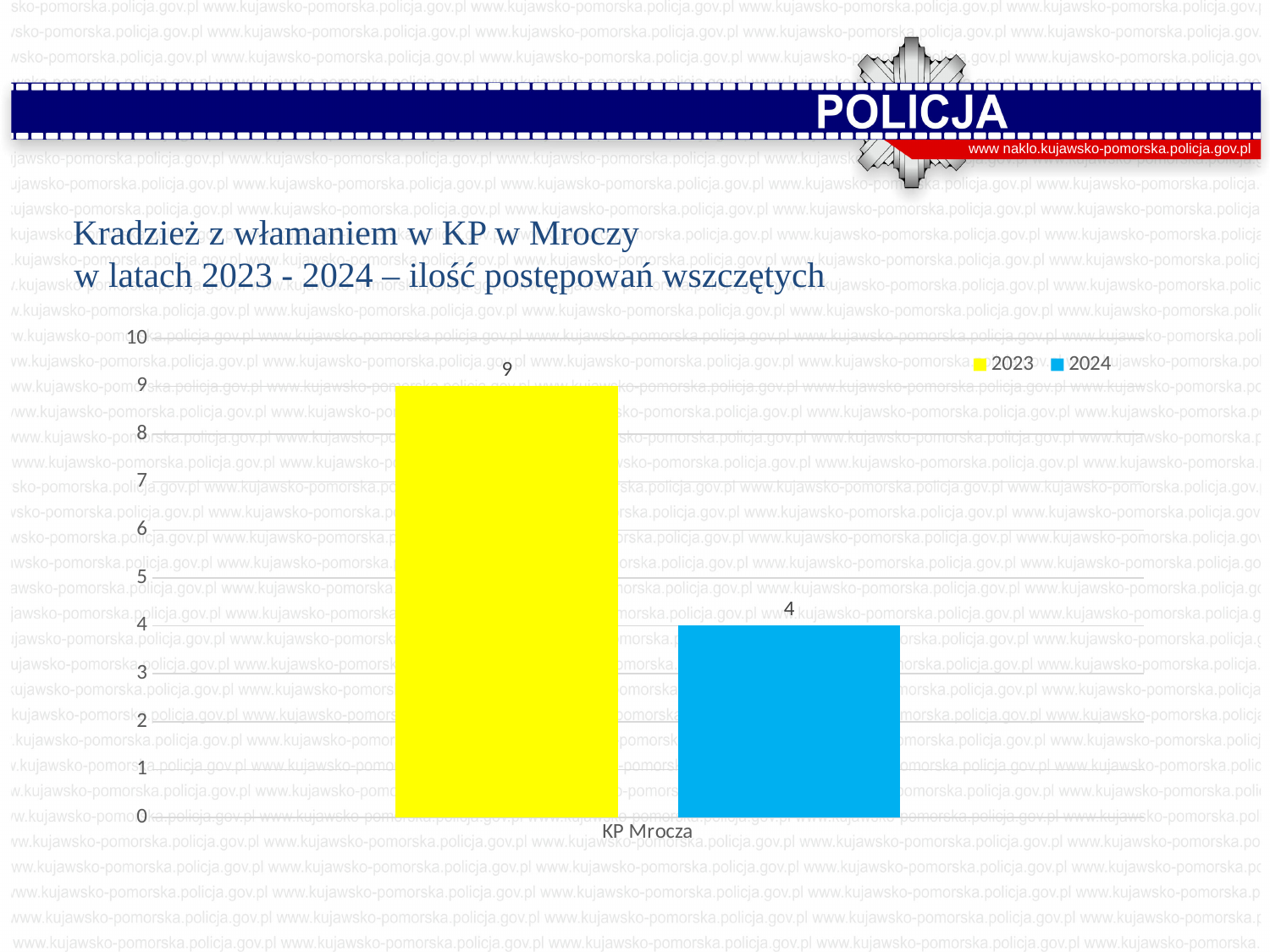
Is the value for 2024 greater or less than 5? less What kind of chart is shown on the slide? bar chart How many categories are shown on the x axis? 1 What is the value for 2024 for KP Mrocza? 4 Is the value for 2023 greater or less than 8? greater What is the value for 2023 for KP Mrocza? 9 What colour represents the 2024 series? blue Which series has the higher value for KP Mrocza, 2023 or 2024? 2023 How many series does the legend list? 2 Which series has the lowest value on the chart? 2024 What is the category label on the x axis? KP Mrocza What is the difference between the 2023 and 2024 values for KP Mrocza? 5